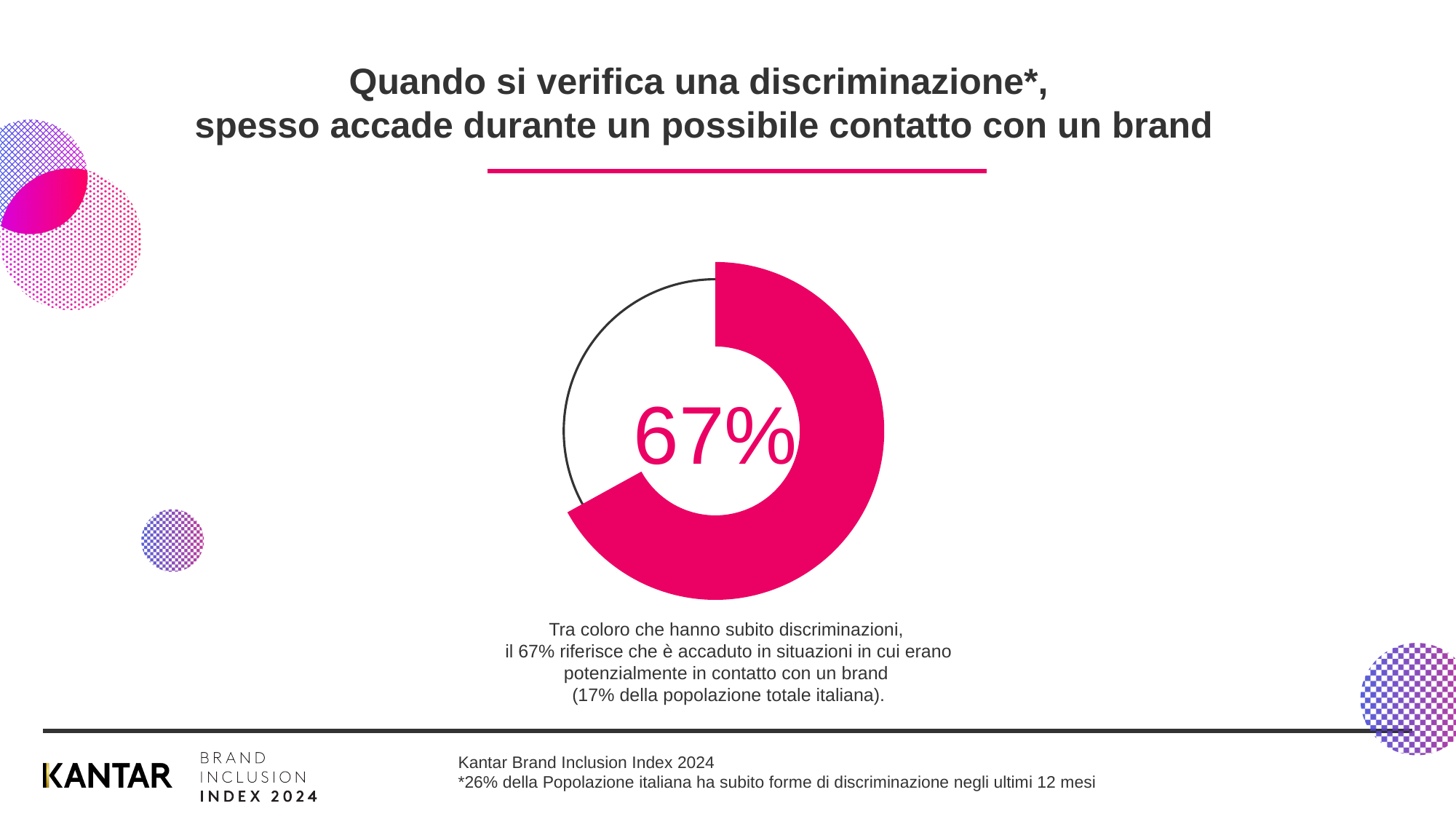
Which segment of the donut chart is larger, the pink filled segment or the white unfilled segment? The pink filled segment Is the value shown in the donut chart greater or less than 50%? greater According to the footnote, what percentage of the Italian population has experienced discrimination in the last 12 months? 26% What share of the donut chart is filled in pink? 67% What colour is the filled segment of the donut chart? Pink (magenta) What percentage is printed in the centre of the donut chart? 67% How many segments does the donut chart have? 2 According to the caption below the chart, what percentage of the total Italian population does the 67% correspond to? 17% What kind of chart is shown on the slide? Donut (pie) chart What is the source cited at the bottom of the slide for the chart? Kantar Brand Inclusion Index 2024